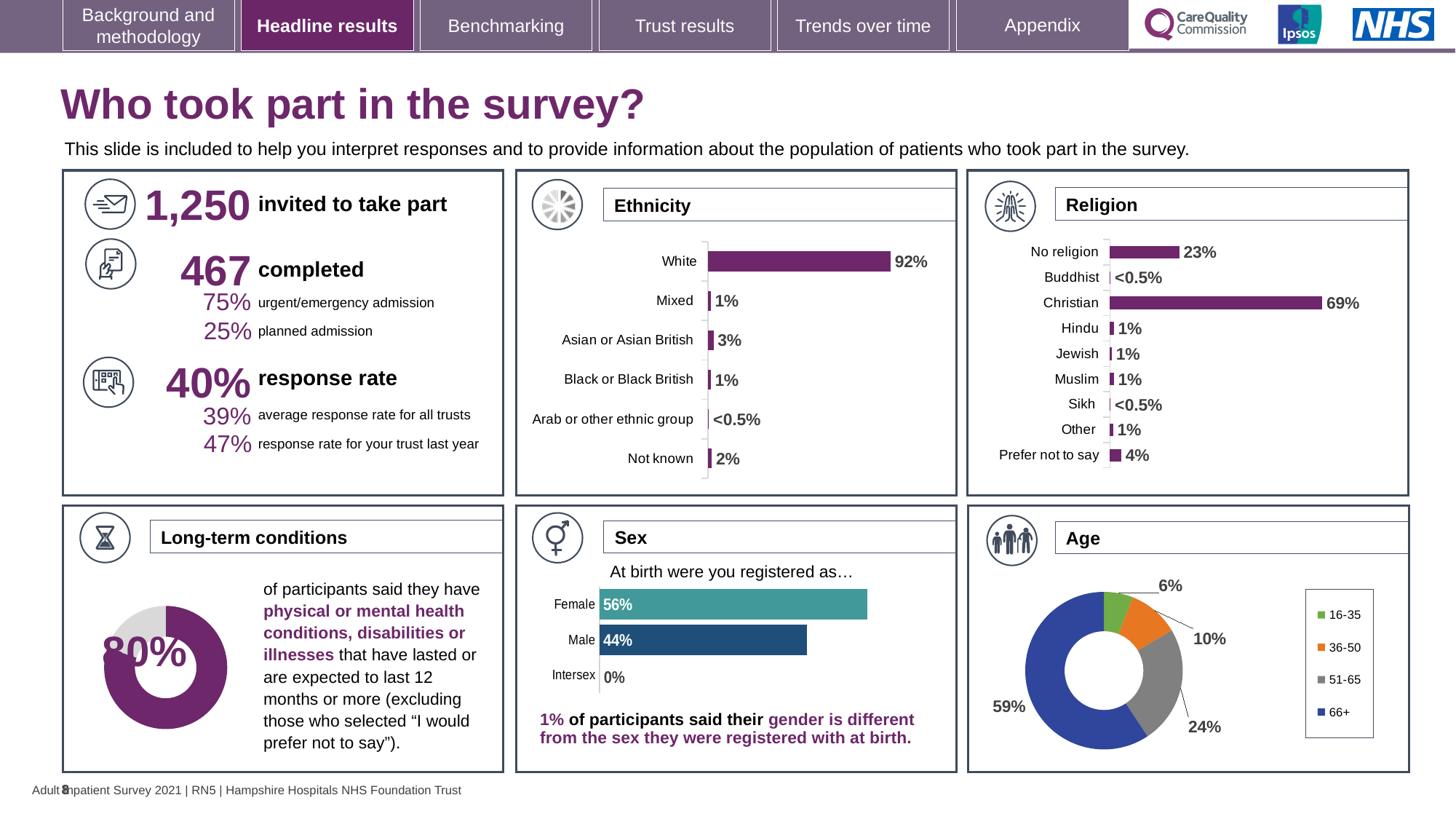
How many ethnic group categories are shown on the Ethnicity chart? 6 On the Ethnicity chart, which ethnic group has the highest percentage? White On the Age chart, which age group has the largest share? 66+ On the Sex chart, which is larger, the Female or the Male percentage? Female How many age groups does the legend of the Age chart list? 4 How many religion categories are listed on the Religion chart? 9 On the Sex chart, what is the difference between the Female and Male percentages? 12 percentage points On the Ethnicity chart, what is the value for Asian or Asian British? 3% On the Ethnicity chart, what percentage of participants were White? 92% On the Religion chart, what percentage of participants were Christian? 69% On the Religion chart, what is the difference between the Christian and No religion percentages? 46 percentage points On the Long-term conditions chart, what percentage of participants said they have a long-term condition? 80%